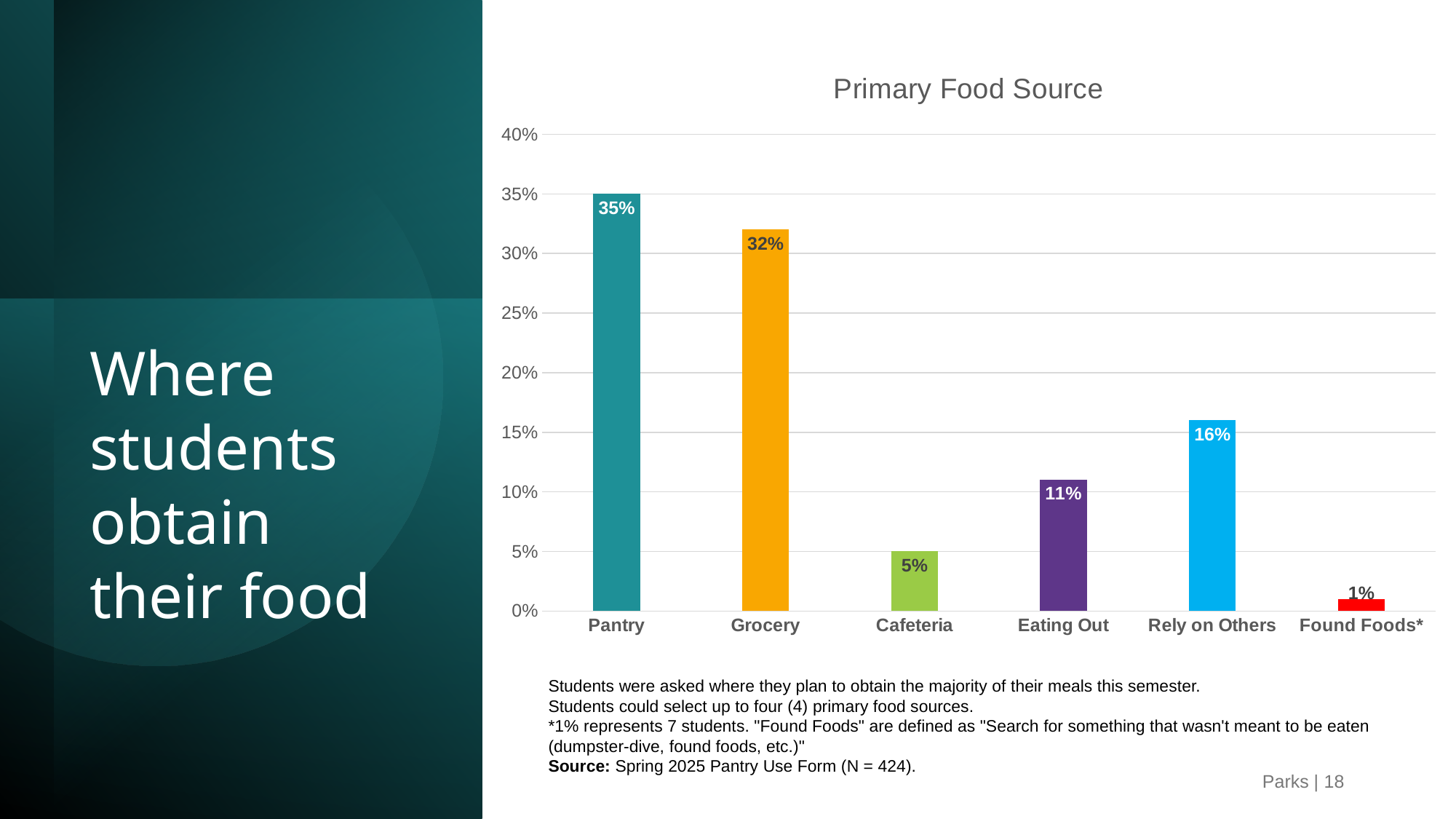
Which category has the lowest value? Found Foods* Which category has the highest value? Pantry What is the difference between the values for Rely on Others and Eating Out? 5% What is the value for Found Foods*? 1% Is the value for Grocery greater or less than 30%? greater What is the value for Rely on Others? 16% What is the title of the chart? Primary Food Source How many categories are shown on the x axis? 6 Which is larger, the value for Cafeteria or the value for Eating Out? Eating Out What kind of chart is shown on the slide? bar chart What is the difference between the values for Pantry and Grocery? 3% What is the value for Pantry? 35%